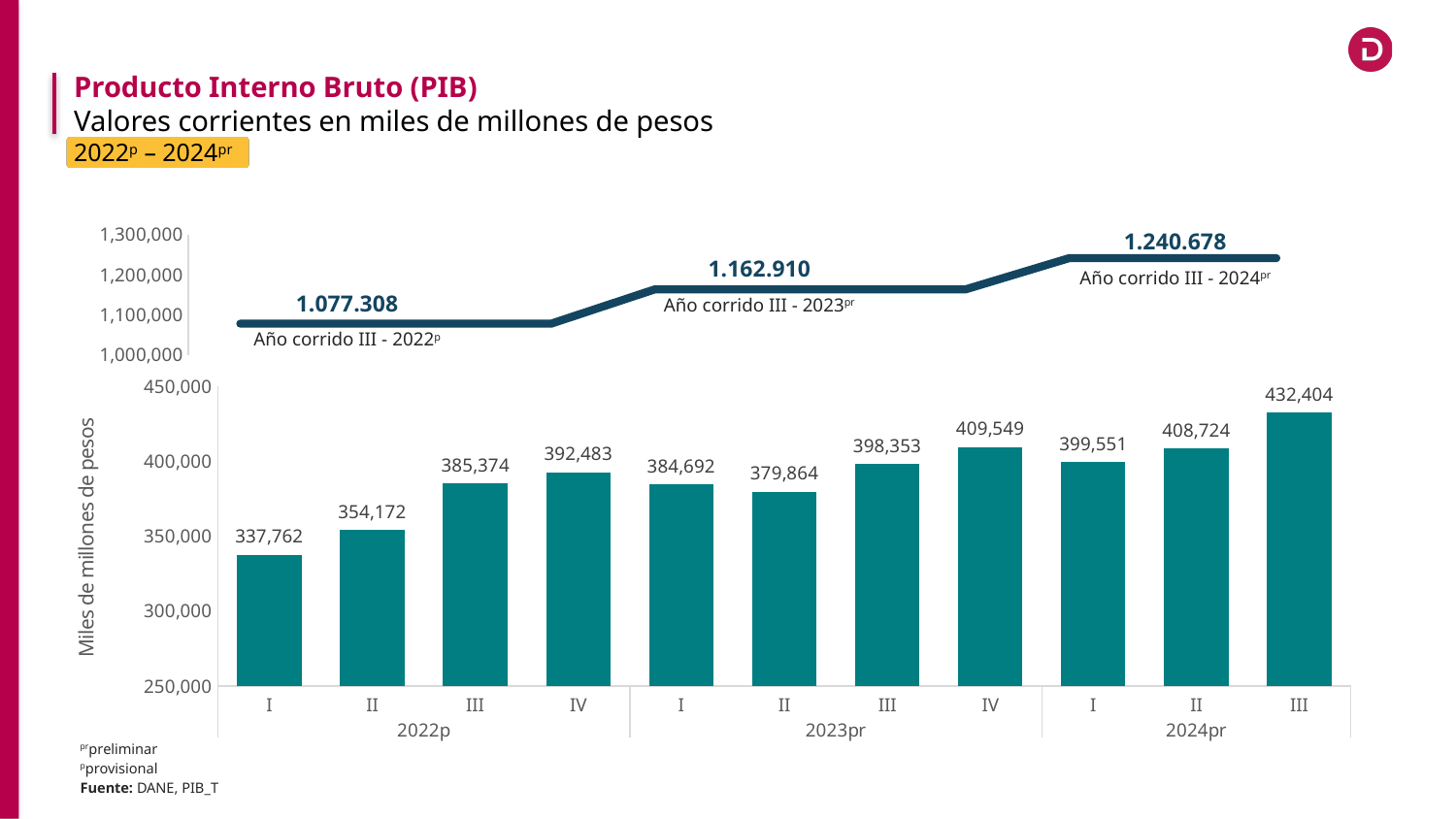
Which is larger, the value for quarter I of 2023pr or quarter II of 2023pr? Quarter I of 2023pr What is the difference between the 'Año corrido III - 2024pr' and 'Año corrido III - 2023pr' values? 77.768 What is the difference between the highest bar (III 2024pr) and the lowest bar (I 2022p)? 94,642 Do the 'Año corrido' values on the line rise or fall from 2022p to 2024pr? rise Which quarter has the lowest value in the bar chart? I of 2022p Is the value for quarter II of 2022p greater or less than 400,000? less What is the 'Año corrido III - 2023pr' value shown on the line at the top of the chart? 1.162.910 What is the label of the vertical axis of the bar chart? Miles de millones de pesos What is the value for quarter IV of 2023pr in the bar chart? 409,549 What is the value for quarter I of 2022p in the bar chart? 337,762 Which quarter has the highest value in the bar chart? III of 2024pr How many quarterly bars are plotted in the bar chart? 11